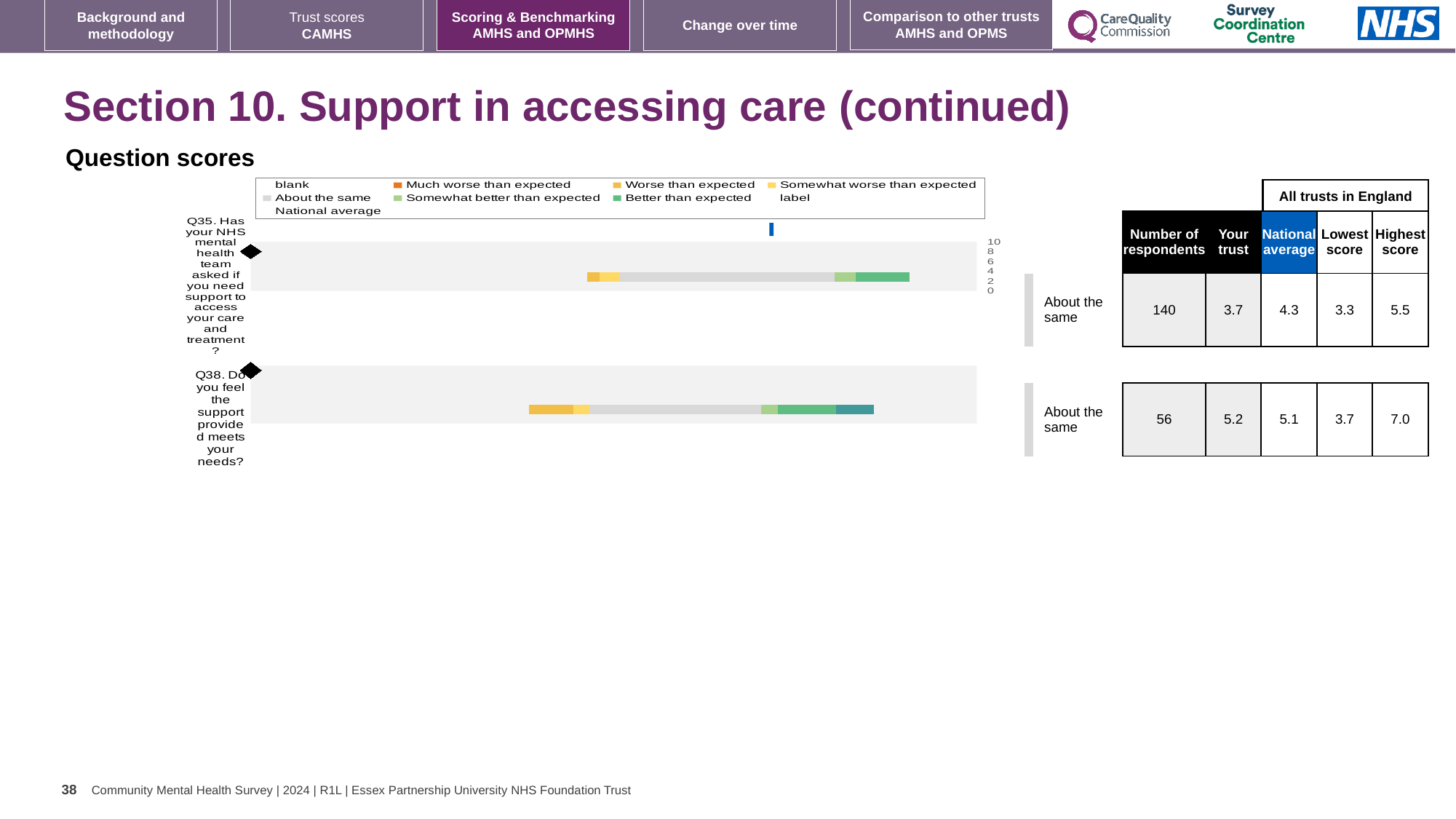
What benchmark label is shown next to the bar for Q38? About the same Which question has the higher 'Your trust' score, Q35 or Q38? Q38 In the table beside the chart, what is the national average for Q38? 5.1 How many entries does the legend of the question scores chart list? 9 In the table beside the chart, what is the 'Your trust' score for Q35? 3.7 What is the difference between the highest score and the lowest score for Q38? 3.3 What is the lowest score across all trusts in England for Q35? 3.3 What kind of chart is used to show the question scores for Q35 and Q38? bar chart How many respondents are listed for Q35? 140 What is the highest score across all trusts in England for Q38? 7.0 How many questions (categories) are plotted in the question scores chart? 2 For Q35, which is larger: the 'Your trust' score or the national average? National average